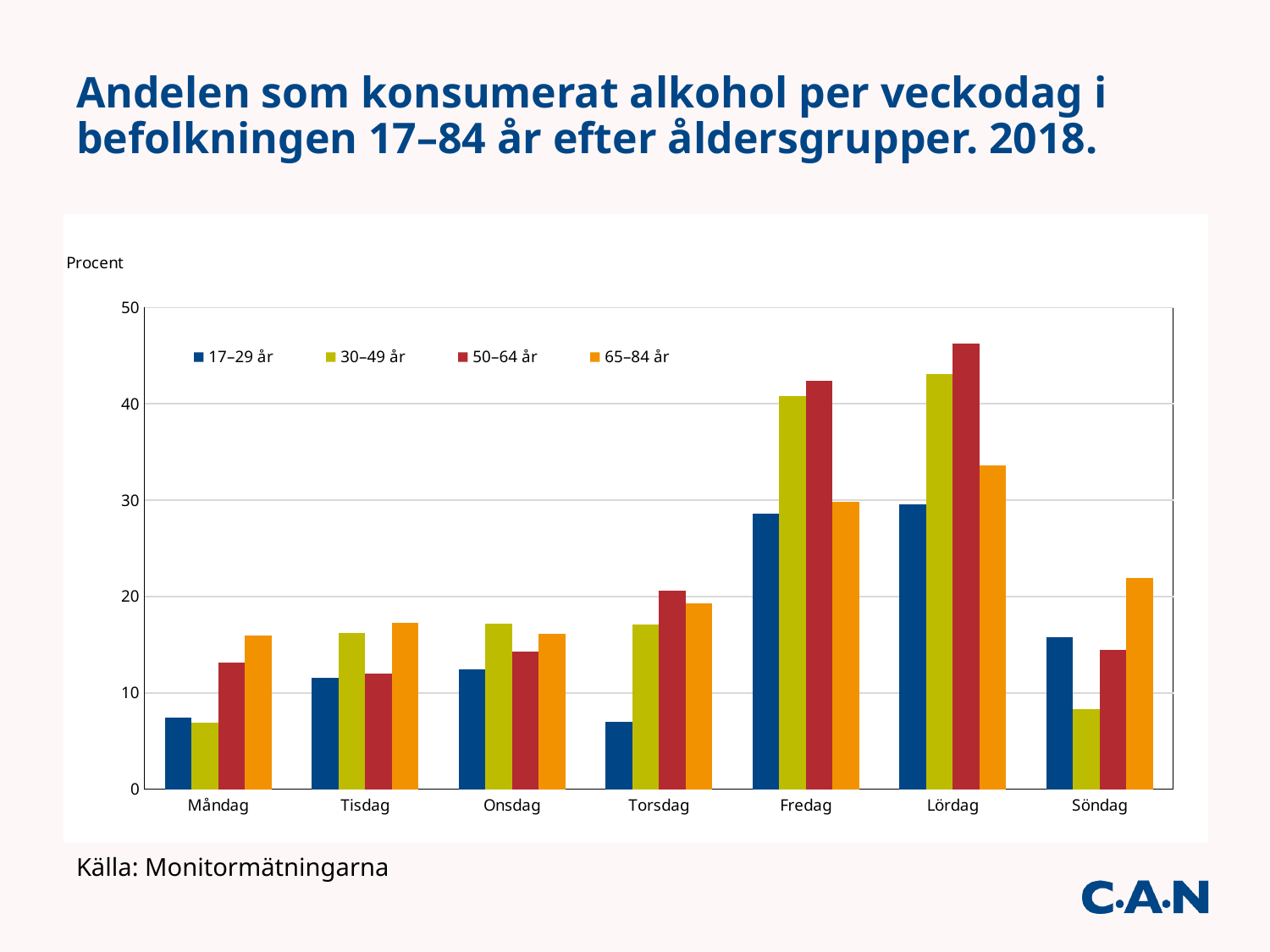
On which weekday is the value for 65–84 år highest? Lördag On Fredag, which is larger: the value for 30–49 år or for 65–84 år? 30–49 år What is the label on the vertical axis of the chart? Procent On Söndag, which is larger: the value for 65–84 år or for 17–29 år? 65–84 år Is the value for 17–29 år on Torsdag greater or less than 10? less How many weekdays are shown on the x axis? 7 Is the value for 65–84 år on Söndag greater or less than 20? greater What kind of chart is shown on the slide? Bar chart How many age-group series does the legend list? 4 On which weekday is the value for 50–64 år highest? Lördag Is the value for 50–64 år on Lördag greater or less than 40? greater